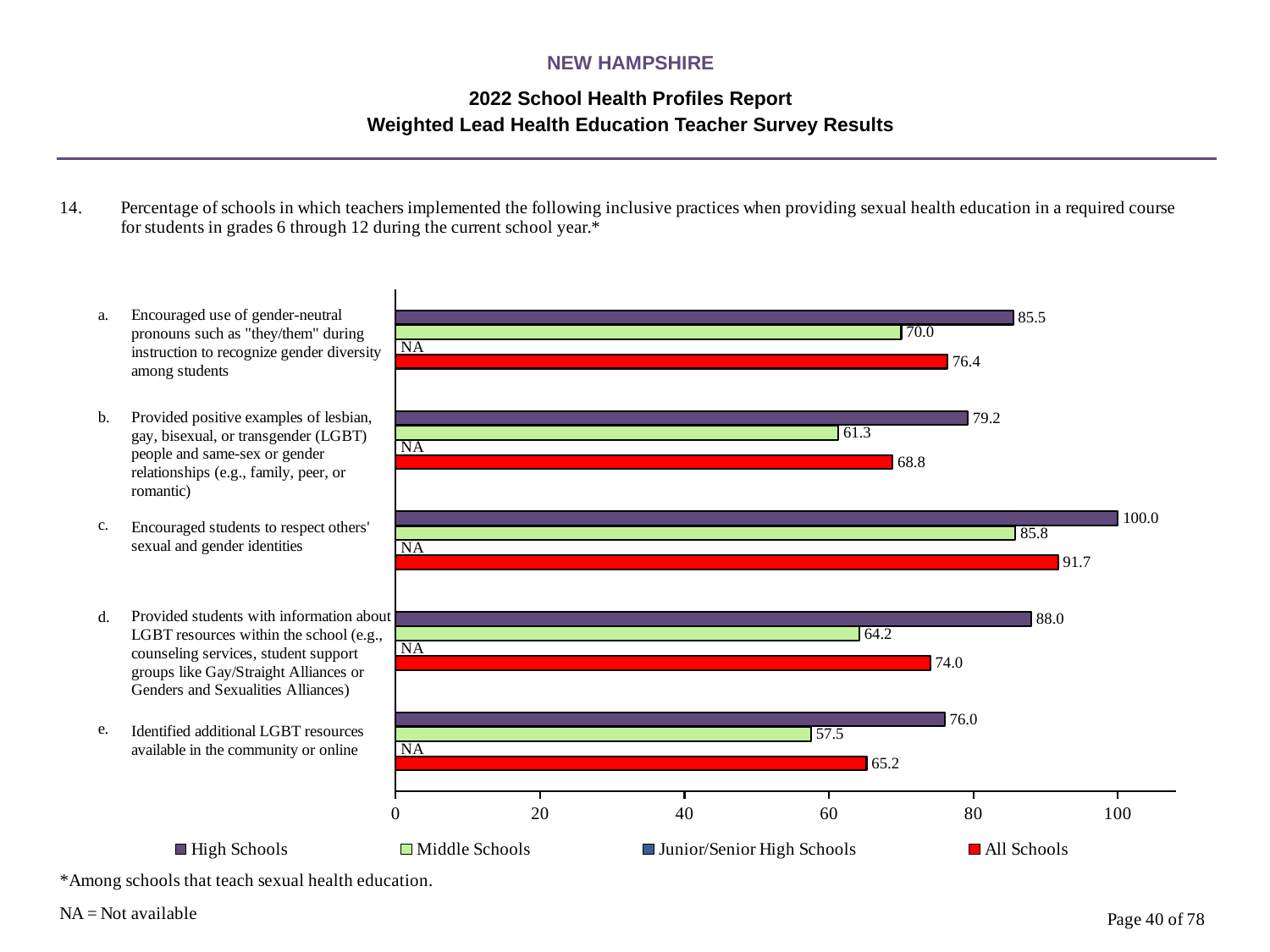
Which item has the highest All Schools value? c. Encouraged students to respect others' sexual and gender identities How many inclusive practices (items) are listed on the chart? 5 Which colour represents All Schools in the chart? Red What is shown for Junior/Senior High Schools for item b, 'Provided positive examples of LGBT people'? NA Which item has the lowest Middle Schools value? e. Identified additional LGBT resources available in the community or online How many series does the legend list? 4 What is the All Schools value for item a, 'Encouraged use of gender-neutral pronouns such as "they/them"'? 76.4 What is the difference between the High Schools and Middle Schools values for item d, 'Provided students with information about LGBT resources within the school'? 23.8 For item b, which is larger: the High Schools value or the All Schools value? High Schools What is the value for Middle Schools for item e, 'Identified additional LGBT resources available in the community or online'? 57.5 What kind of chart is shown on the slide? Bar chart What is the value for High Schools for item c, 'Encouraged students to respect others' sexual and gender identities'? 100.0